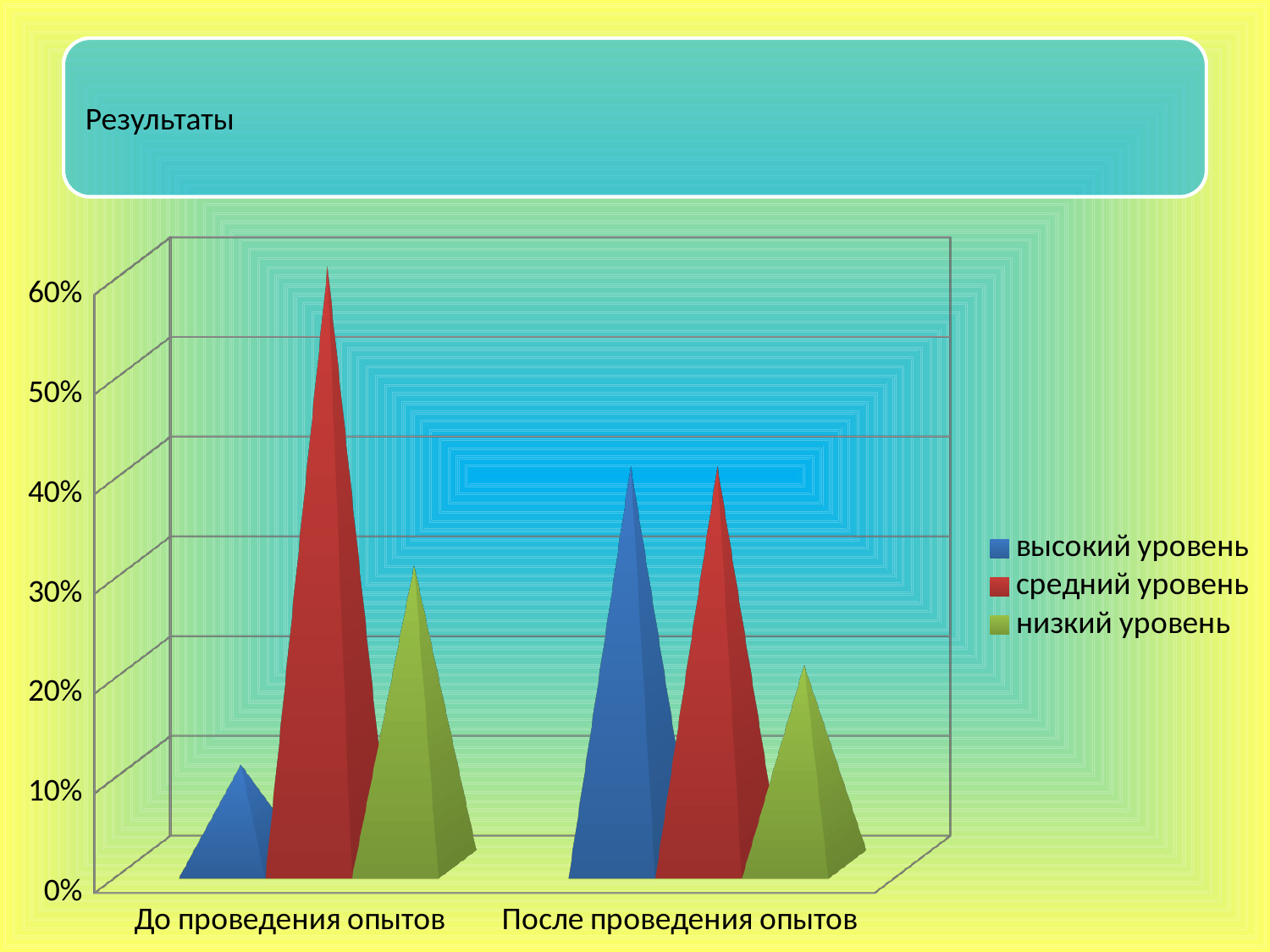
Is the value for "высокий уровень" in "До проведения опытов" greater or less than 20%? less Does the value for "средний уровень" rise or fall from "До проведения опытов" to "После проведения опытов"? fall How many categories are shown on the x axis? 2 Which series has the lowest value for "После проведения опытов"? низкий уровень What kind of chart is shown on the slide? bar chart Which series has the highest value for "До проведения опытов"? средний уровень Which is larger: the value for "высокий уровень" in "До проведения опытов" or in "После проведения опытов"? После проведения опытов Is the value for "низкий уровень" in "После проведения опытов" greater or less than 30%? less How many series does the legend list? 3 Which series has the lowest value for "До проведения опытов"? высокий уровень Is the value for "средний уровень" in "До проведения опытов" greater or less than 50%? greater What colour represents "низкий уровень" in the legend? green